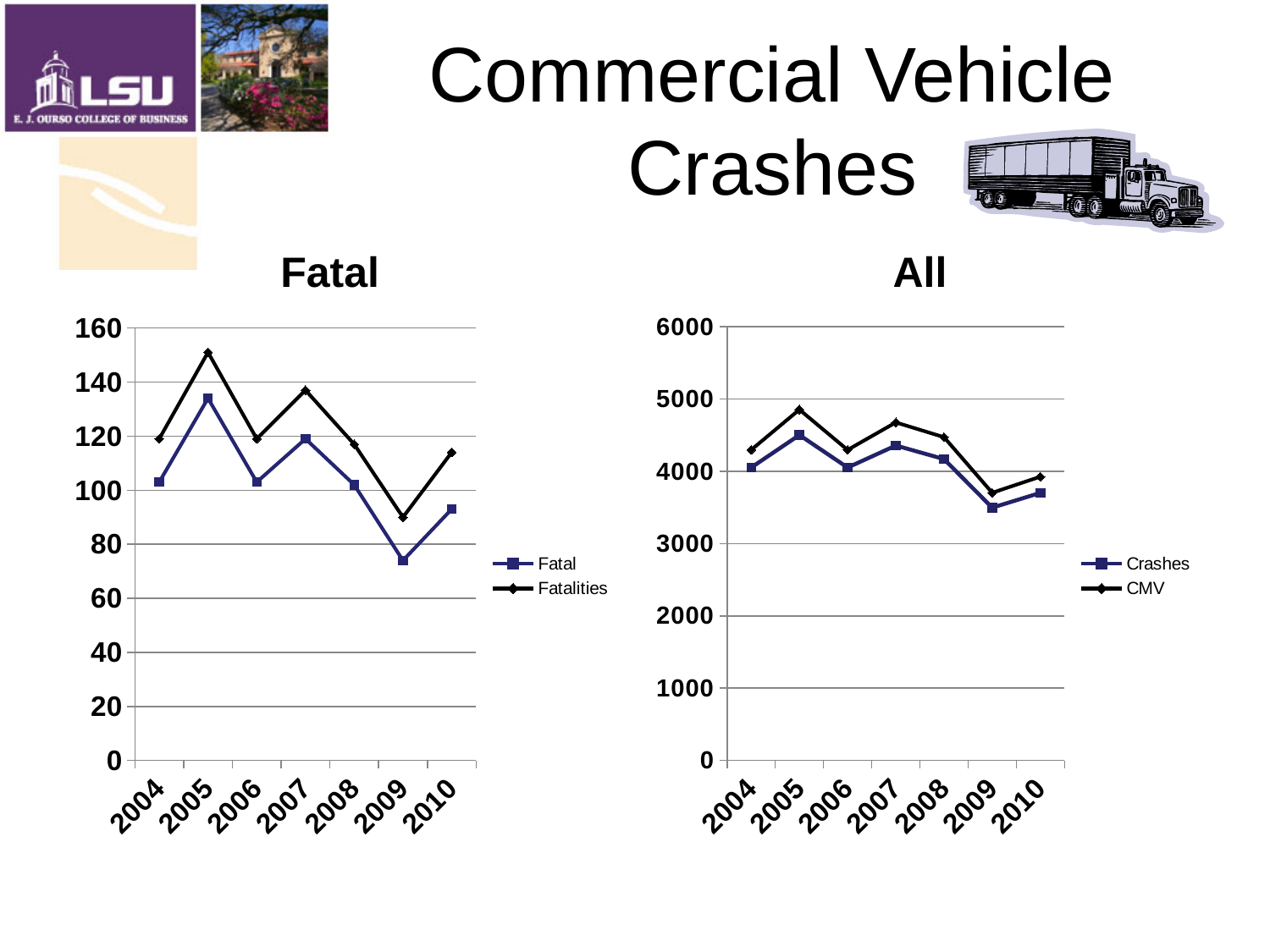
In the "Fatal" chart, is the Fatal value for 2009 greater or less than 80? less What kind of chart is the "Fatal" chart on the left? line chart In the "All" chart, which year has the highest CMV value? 2005 How many years are plotted along the x axis of the "Fatal" chart? 7 In the "All" chart, is the CMV value for 2005 greater or less than 5000? less In the "Fatal" chart, is the Fatalities value for 2005 greater or less than 140? greater In the "Fatal" chart, which year has the highest value for Fatalities? 2005 How many series does the legend of the "Fatal" chart list? 2 What are the two series listed in the legend of the "All" chart? Crashes and CMV In the "All" chart, is the Crashes value larger in 2005 or in 2010? 2005 In the "Fatal" chart, which year has the lowest value for the Fatal series? 2009